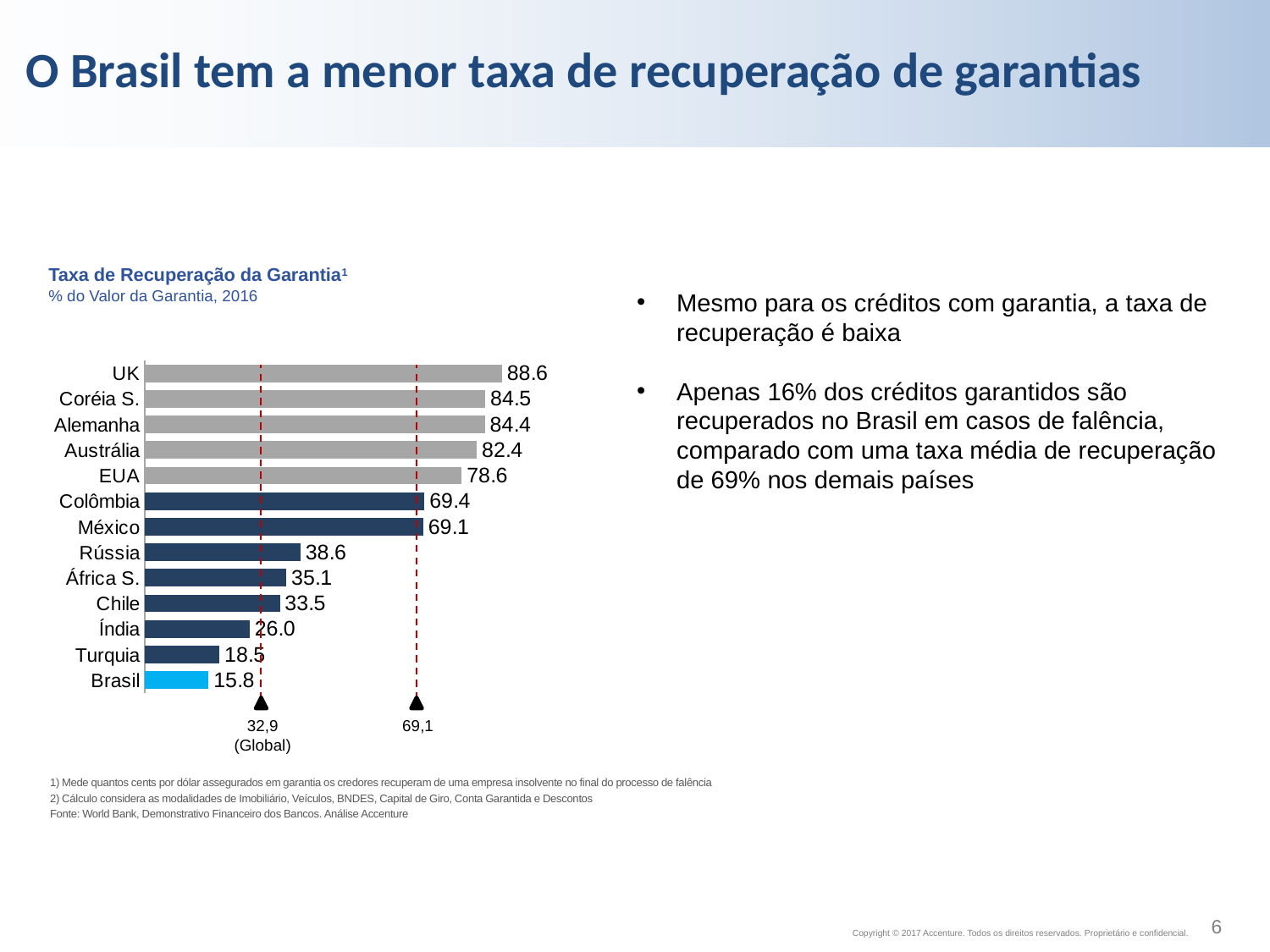
What kind of chart is shown on the slide? Bar chart What is the value for Rússia in the chart? 38.6 What is the difference between the values for UK and Brasil? 72.8 Which country has the lowest value in the chart? Brasil What is the difference between the values for Colômbia and México? 0.3 How many countries are shown in the chart? 13 Which has a larger value, Chile or Índia? Chile What is the value for Alemanha in the chart? 84.4 What is the value for Brasil in the Taxa de Recuperação da Garantia chart? 15.8 Which country has the highest value in the chart? UK What value does the dashed line labelled '(Global)' mark in the chart? 32,9 Which has a larger value, Austrália or EUA? Austrália